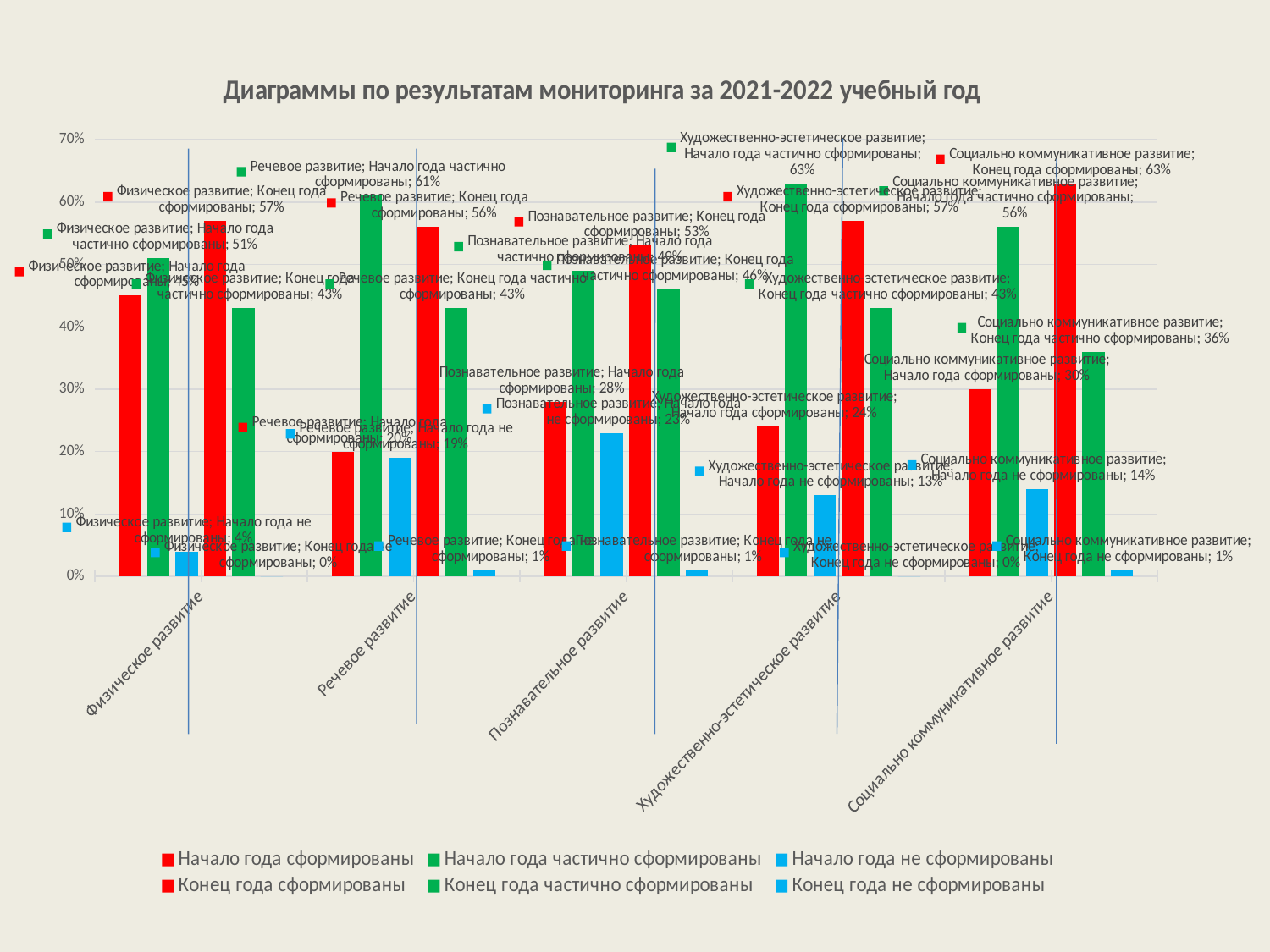
Is the value for Речевое развитие, Начало года сформированы greater or less than 30%? less How many series does the legend list? 6 What is the value for Физическое развитие, Конец года сформированы? 57% For Речевое развитие, what is the difference between Конец года сформированы (56%) and Начало года сформированы (20%)? 36 percentage points What is the value for Художественно-эстетическое развитие, Начало года частично сформированы? 63% What kind of chart is shown on the slide? Bar chart What is the value for Речевое развитие, Начало года частично сформированы? 61% How many categories are shown on the x axis? 5 What is the value for Социально коммуникативное развитие, Конец года сформированы? 63% What is the title of the chart? Диаграммы по результатам мониторинга за 2021-2022 учебный год For Физическое развитие, which is larger: Начало года частично сформированы or Конец года частично сформированы? Начало года частично сформированы Which category has the highest value for Конец года сформированы? Социально коммуникативное развитие